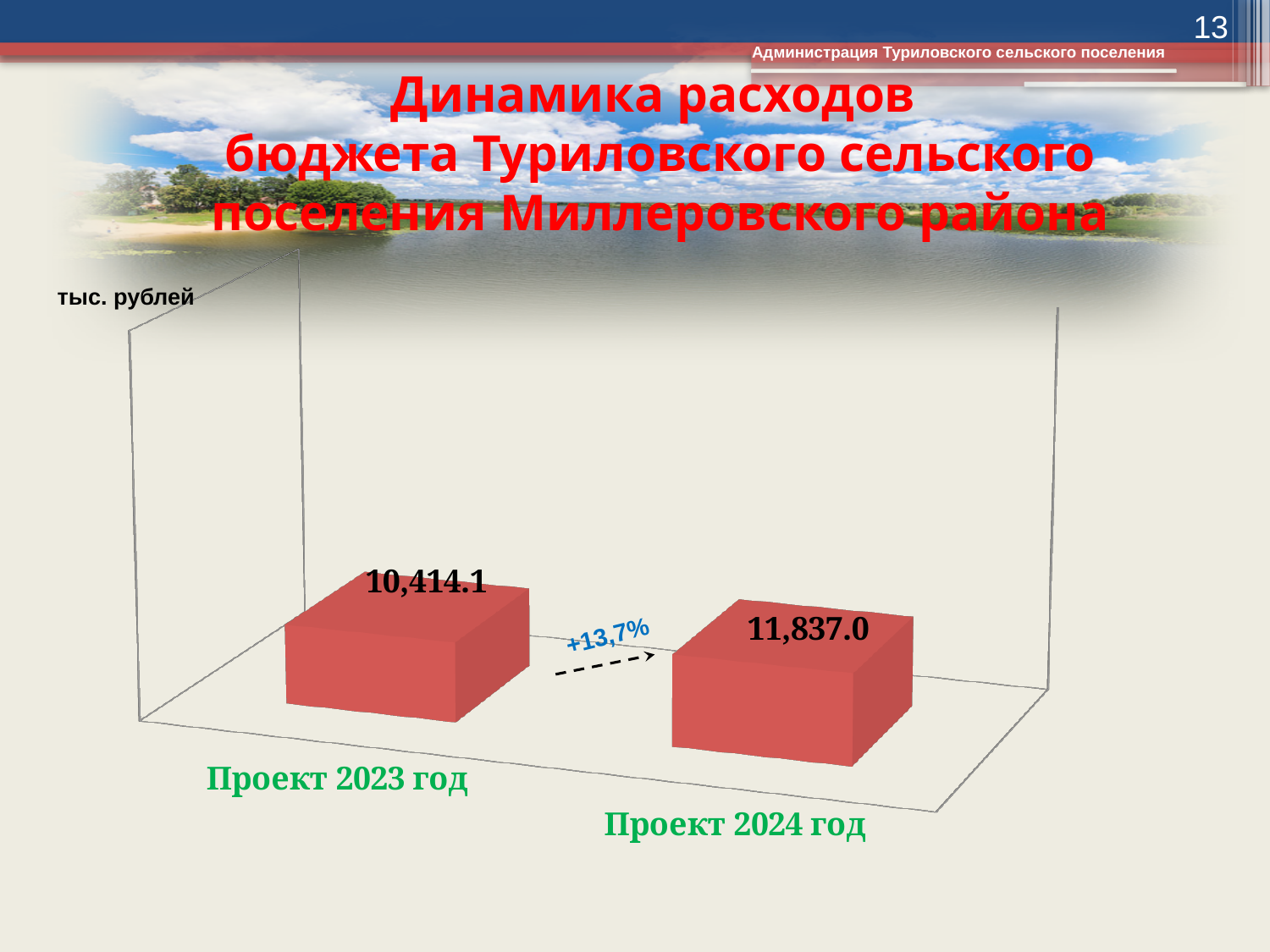
What unit of measurement is indicated on the chart? тыс. рублей What is the difference between the values for Проект 2024 год and Проект 2023 год? 1,422.9 What is the value for Проект 2023 год? 10,414.1 Which category has the lowest value? Проект 2023 год What percentage change is annotated between the two bars? +13,7% What is the value for Проект 2024 год? 11,837.0 Do the values rise or fall from Проект 2023 год to Проект 2024 год? Rise What kind of chart is shown on the slide? Bar chart Which is larger, the value for Проект 2023 год or the value for Проект 2024 год? Проект 2024 год How many categories are shown in the chart? 2 Which category has the highest value? Проект 2024 год